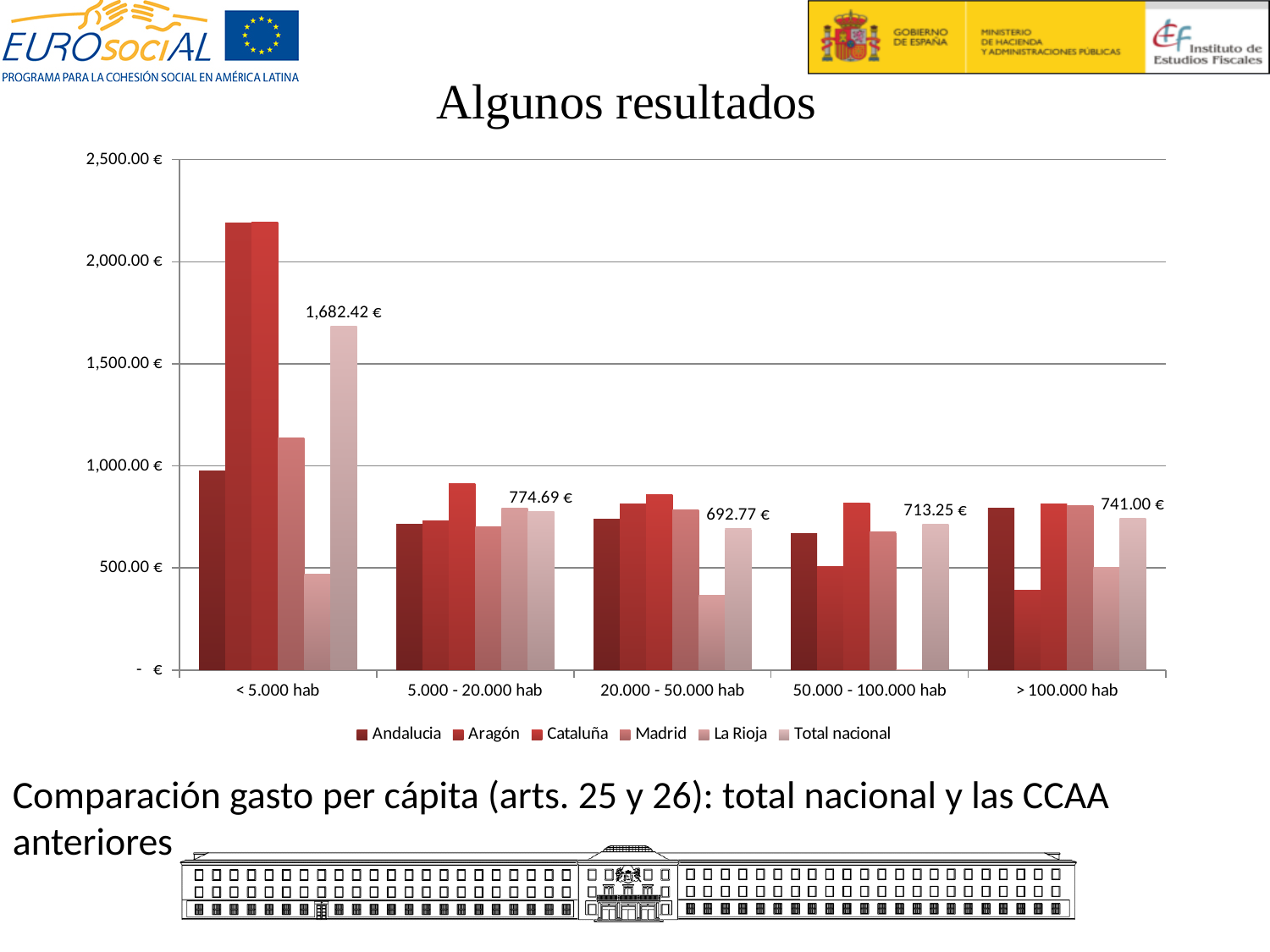
Is the value for Aragón in the < 5.000 hab category greater or less than 2,000.00 €? greater What is the value for Total nacional in the < 5.000 hab category? 1,682.42 € What is the value for Total nacional in the > 100.000 hab category? 741.00 € How many series does the legend list? 6 How many population categories are shown on the x axis? 5 Is the value for La Rioja in the 20.000 - 50.000 hab category greater or less than 500.00 €? less What kind of chart is shown on the slide? bar chart What is the value for Total nacional in the 20.000 - 50.000 hab category? 692.77 € Which is larger: the Total nacional value for 5.000 - 20.000 hab or for > 100.000 hab? 5.000 - 20.000 hab What is the difference between the Total nacional values for < 5.000 hab and 5.000 - 20.000 hab? 907.73 € In which population category is the Total nacional value highest? < 5.000 hab In which population category is the Total nacional value lowest? 20.000 - 50.000 hab